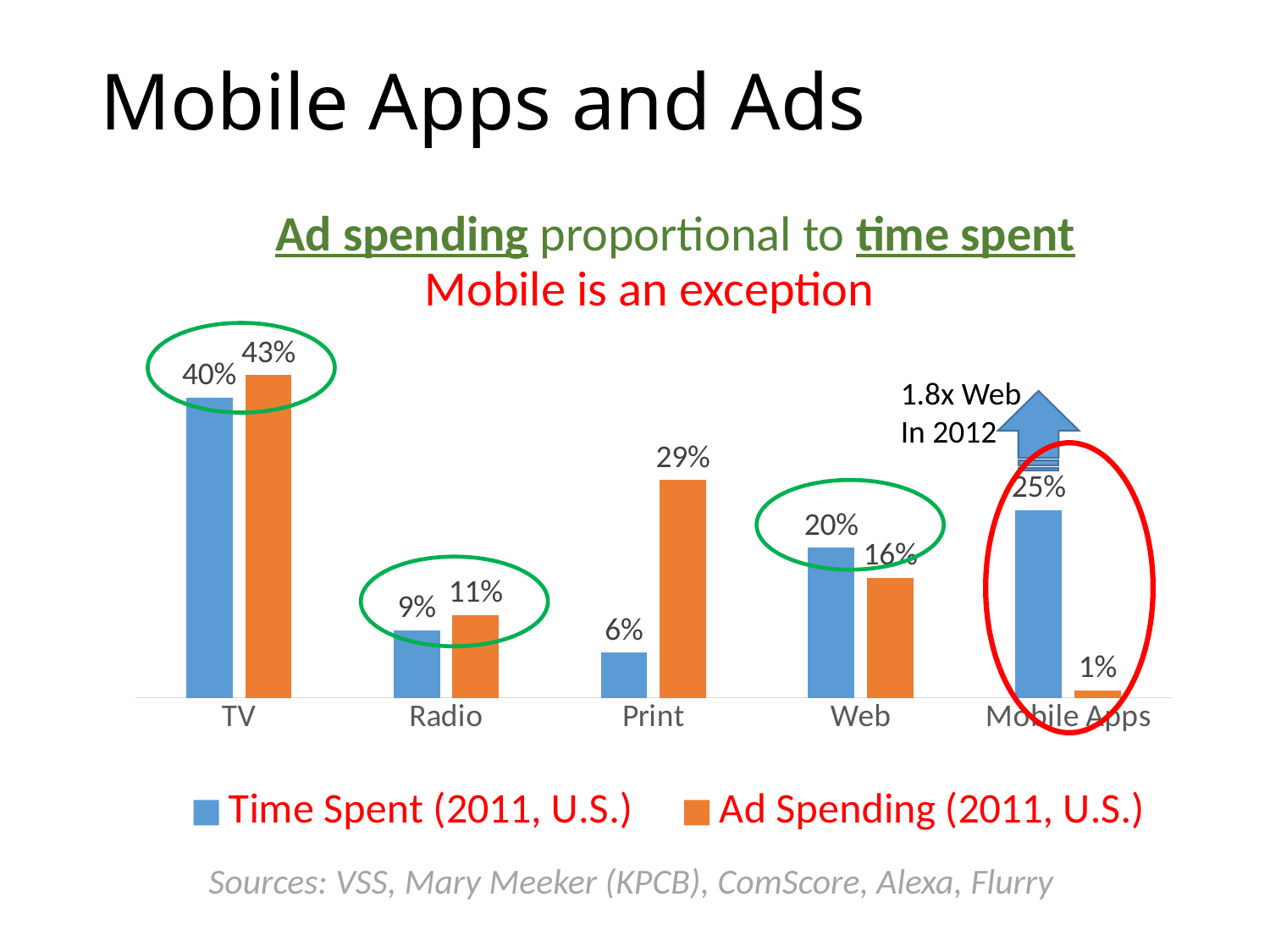
What is the Ad Spending (2011, U.S.) value for Mobile Apps? 1% What is the Time Spent (2011, U.S.) value for Web? 20% What kind of chart is shown on the slide? Bar chart How many series does the legend list? 2 What is the Ad Spending (2011, U.S.) value for Print? 29% How many categories are shown on the x axis? 5 Which category has the lowest Time Spent (2011, U.S.) value? Print What is the difference between Time Spent and Ad Spending for Mobile Apps? 24% Which colour represents the Ad Spending (2011, U.S.) series? Orange What is the Time Spent (2011, U.S.) value for TV? 40% Which is larger for Print: Time Spent (2011, U.S.) or Ad Spending (2011, U.S.)? Ad Spending (2011, U.S.) Which category has the highest Ad Spending (2011, U.S.) value? TV